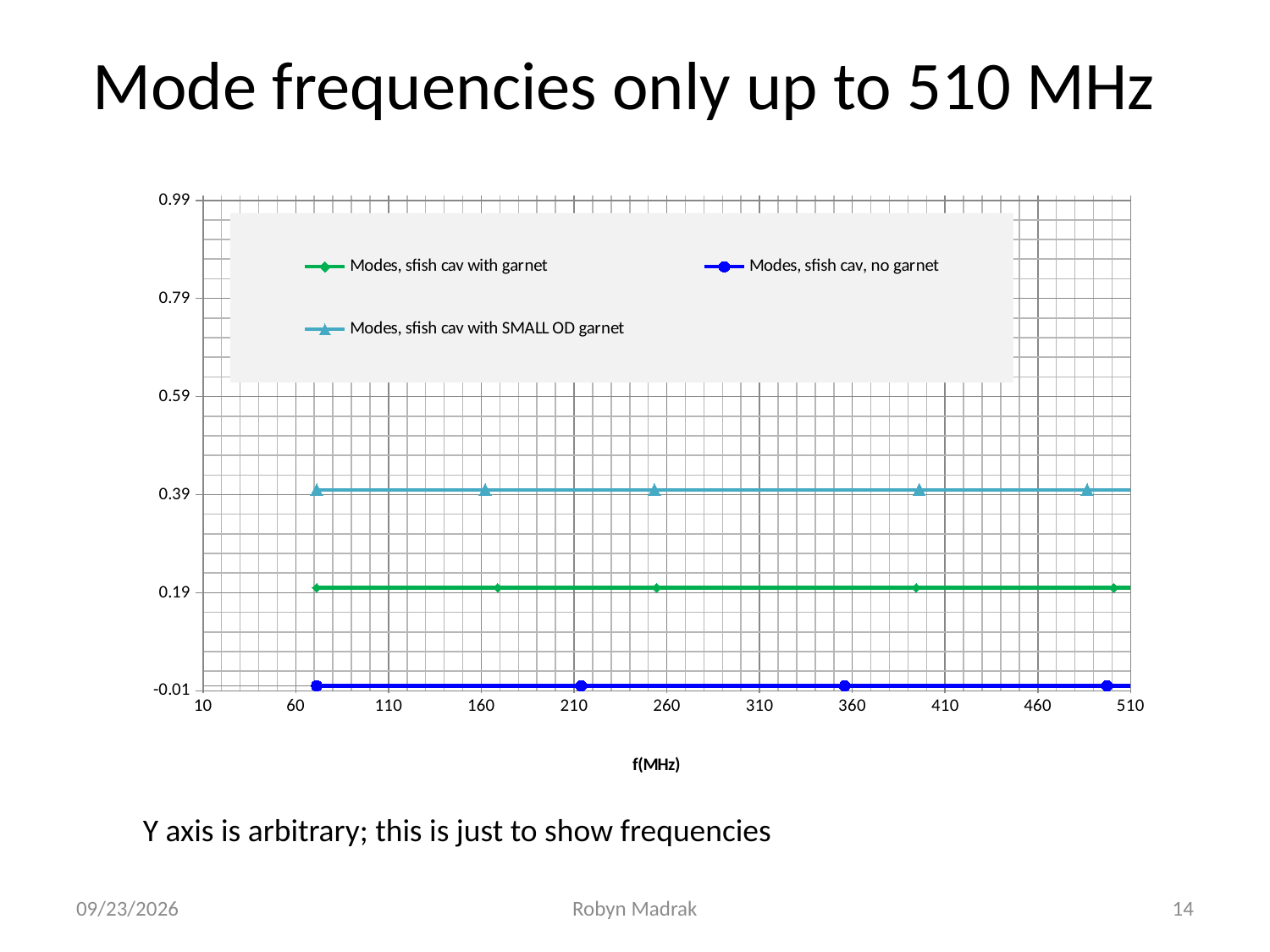
How many series does the legend list? 3 How many data points are plotted for the 'Modes, sfish cav with garnet' series? 5 Which series is plotted highest on the chart? Modes, sfish cav with SMALL OD garnet Which series is plotted lowest on the chart? Modes, sfish cav, no garnet What is the title of the chart on the slide? Mode frequencies only up to 510 MHz How many data points are plotted for the 'Modes, sfish cav, no garnet' series? 4 What is the label of the x axis? f(MHz) Which series is plotted higher, 'Modes, sfish cav with garnet' or 'Modes, sfish cav with SMALL OD garnet'? Modes, sfish cav with SMALL OD garnet Which series is plotted higher, 'Modes, sfish cav with garnet' or 'Modes, sfish cav, no garnet'? Modes, sfish cav with garnet Do the values of the 'Modes, sfish cav with garnet' series rise, fall, or stay flat along the x axis? stay flat What kind of chart is shown on the slide? line chart Are the values for the 'Modes, sfish cav with SMALL OD garnet' series greater or less than 0.59? less